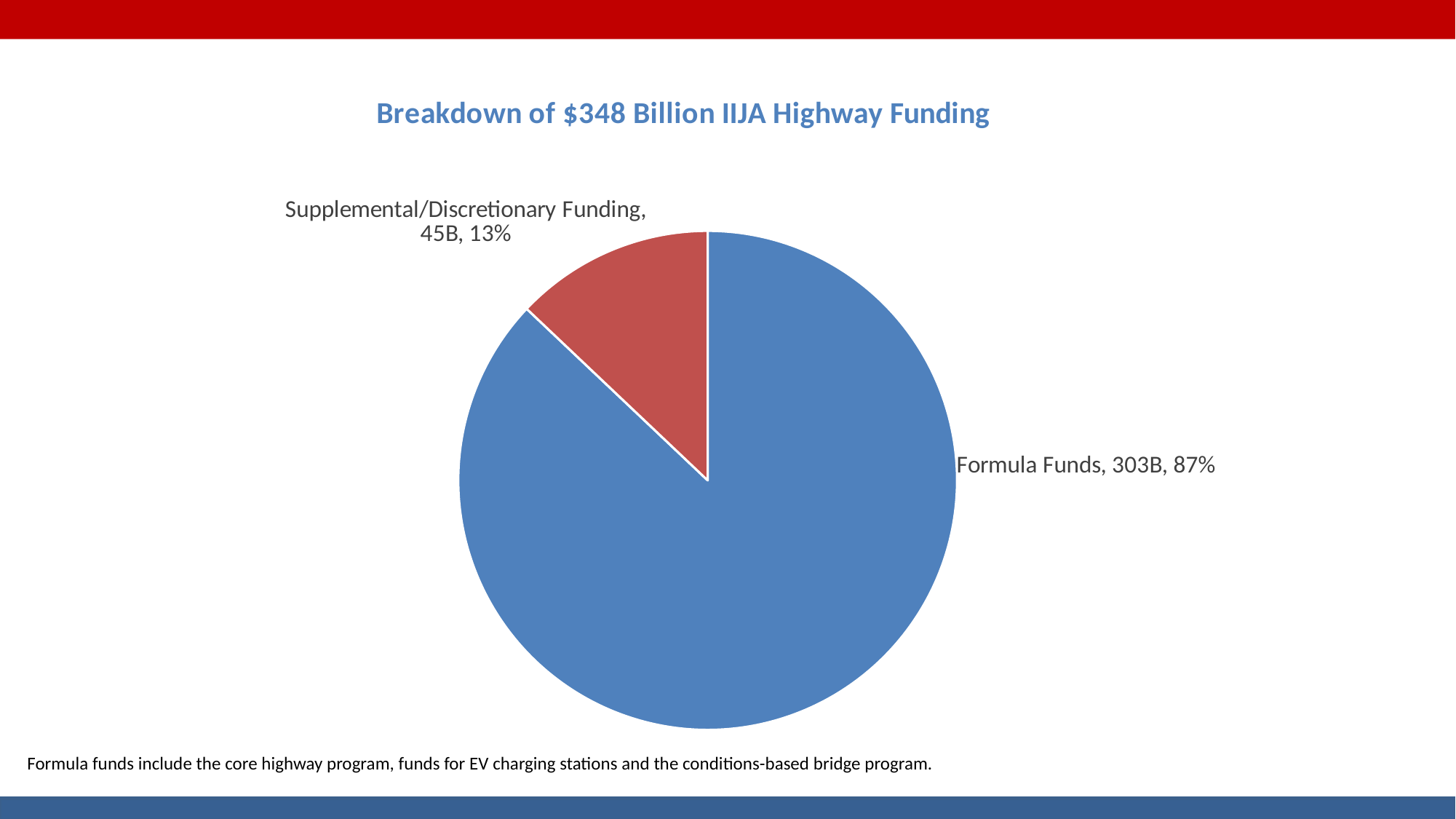
What share of the pie does Formula Funds represent? 87% Which slice is the largest? Formula Funds How many slices does the pie chart have? 2 What share of the pie does Supplemental/Discretionary Funding represent? 13% What kind of chart is shown on the slide? Pie chart Which slice is the smallest? Supplemental/Discretionary Funding What colour is the Supplemental/Discretionary Funding slice? Red What is the difference in billions between Formula Funds and Supplemental/Discretionary Funding? 258B What is the title of the chart? Breakdown of $348 Billion IIJA Highway Funding What is the value for Supplemental/Discretionary Funding? 45B What is the value for Formula Funds? 303B Which is larger, Formula Funds or Supplemental/Discretionary Funding? Formula Funds